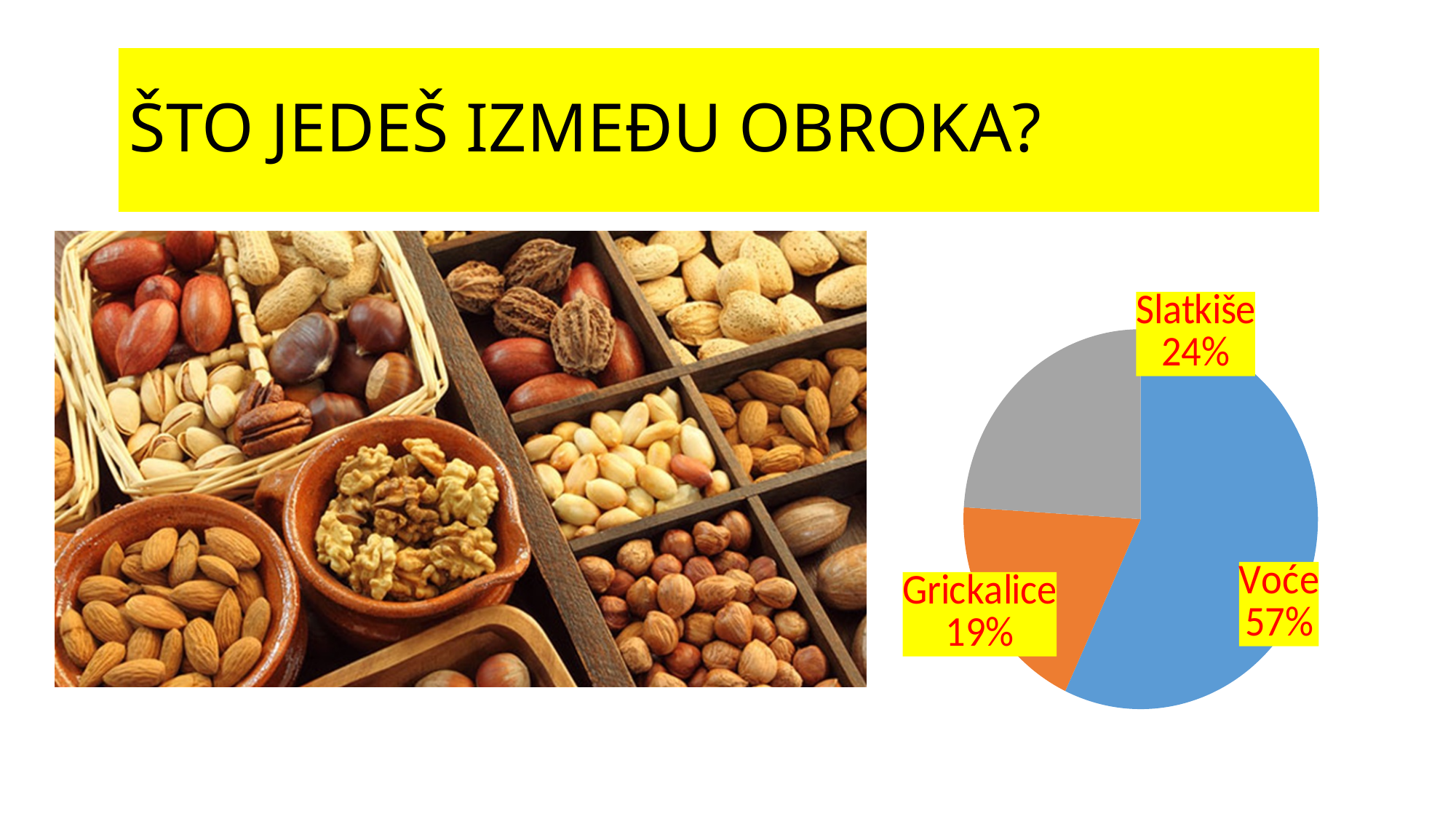
What colour is the Grickalice slice of the pie chart? Orange Which is larger, the share for Slatkiše or the share for Grickalice? Slatkiše Which category has the largest share of the pie chart? Voće What is the difference in percentage points between Slatkiše and Grickalice? 5 Which category has the smallest share of the pie chart? Grickalice How many categories are shown in the pie chart? 3 What percentage of the pie chart is Voće? 57% What is the difference in percentage points between Voće and Slatkiše? 33 What percentage of the pie chart is Grickalice? 19% What percentage of the pie chart is Slatkiše? 24% What kind of chart is shown on the slide? Pie chart What colour is the Voće slice of the pie chart? Blue